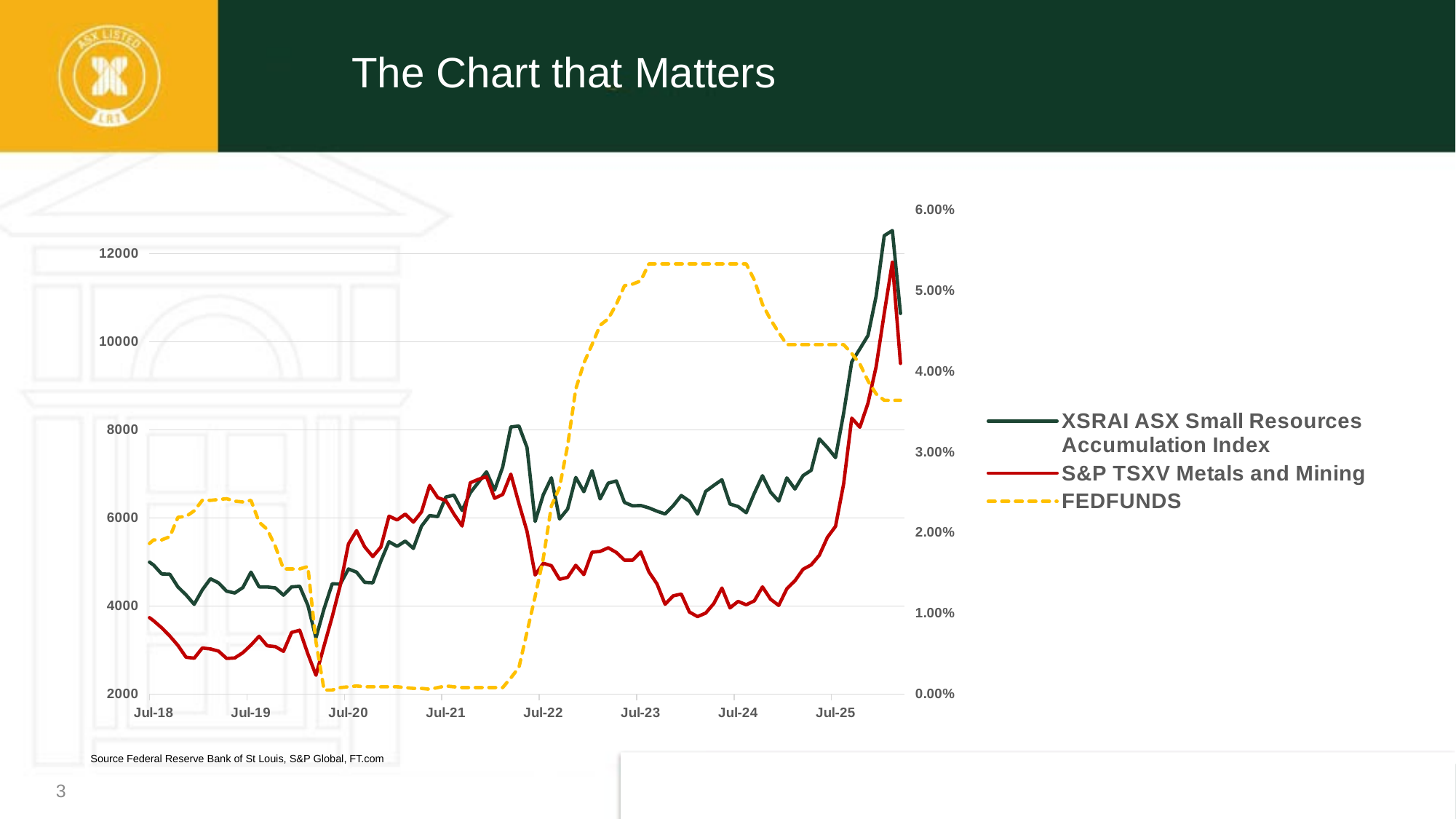
What is the title of the slide containing the chart? The Chart that Matters Is the XSRAI ASX Small Resources Accumulation Index value at Jul-19 greater or less than 4000? greater Does the XSRAI ASX Small Resources Accumulation Index reach its highest value near the start or near the end of the period shown? near the end How many labelled tick marks are on the x axis of the chart? 8 Is the FEDFUNDS value at Jul-23 greater or less than 5.00%? greater Does the FEDFUNDS series rise or fall between Jul-22 and Jul-23? rise Is the FEDFUNDS value at Jul-20 greater or less than 1.00%? less What kind of chart is shown on the slide? line chart How many series does the legend list? 3 Which series is drawn as a dashed line in the chart? FEDFUNDS